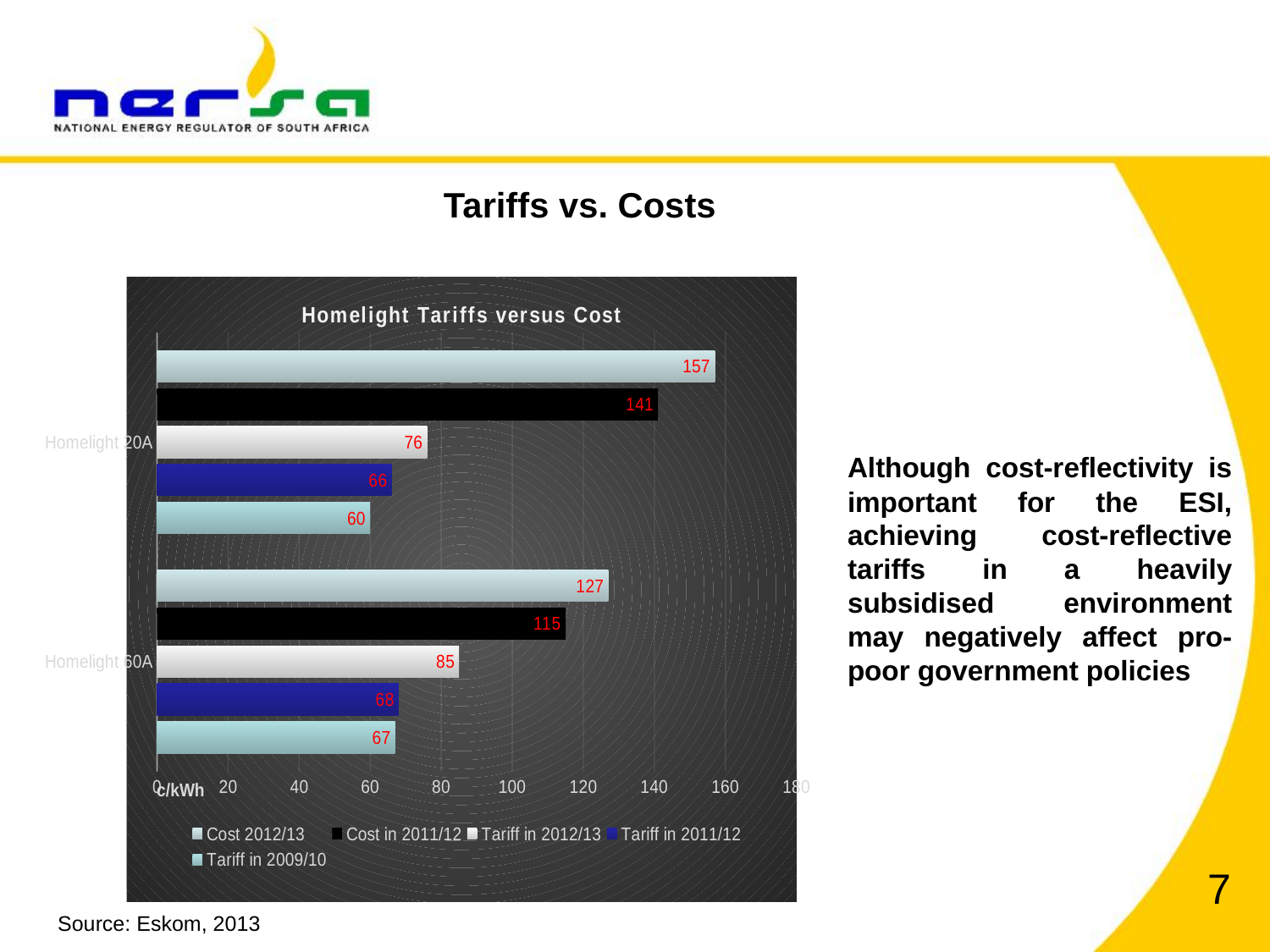
How many categories are shown on the chart? 2 What is the Tariff in 2009/10 value for Homelight 20A? 60 What is the Tariff in 2012/13 value for Homelight 60A? 85 How many series does the legend list? 5 What is the title of the chart? Homelight Tariffs versus Cost Which series has the highest value for Homelight 20A? Cost 2012/13 What type of chart is shown on the slide? Bar chart What is the difference between Cost 2012/13 and Tariff in 2012/13 for Homelight 20A? 81 Which is larger: the Tariff in 2011/12 for Homelight 20A or for Homelight 60A? Homelight 60A What is the Cost in 2011/12 value for Homelight 60A? 115 What is the Cost 2012/13 value for Homelight 20A? 157 Which series has the lowest value for Homelight 60A? Tariff in 2009/10